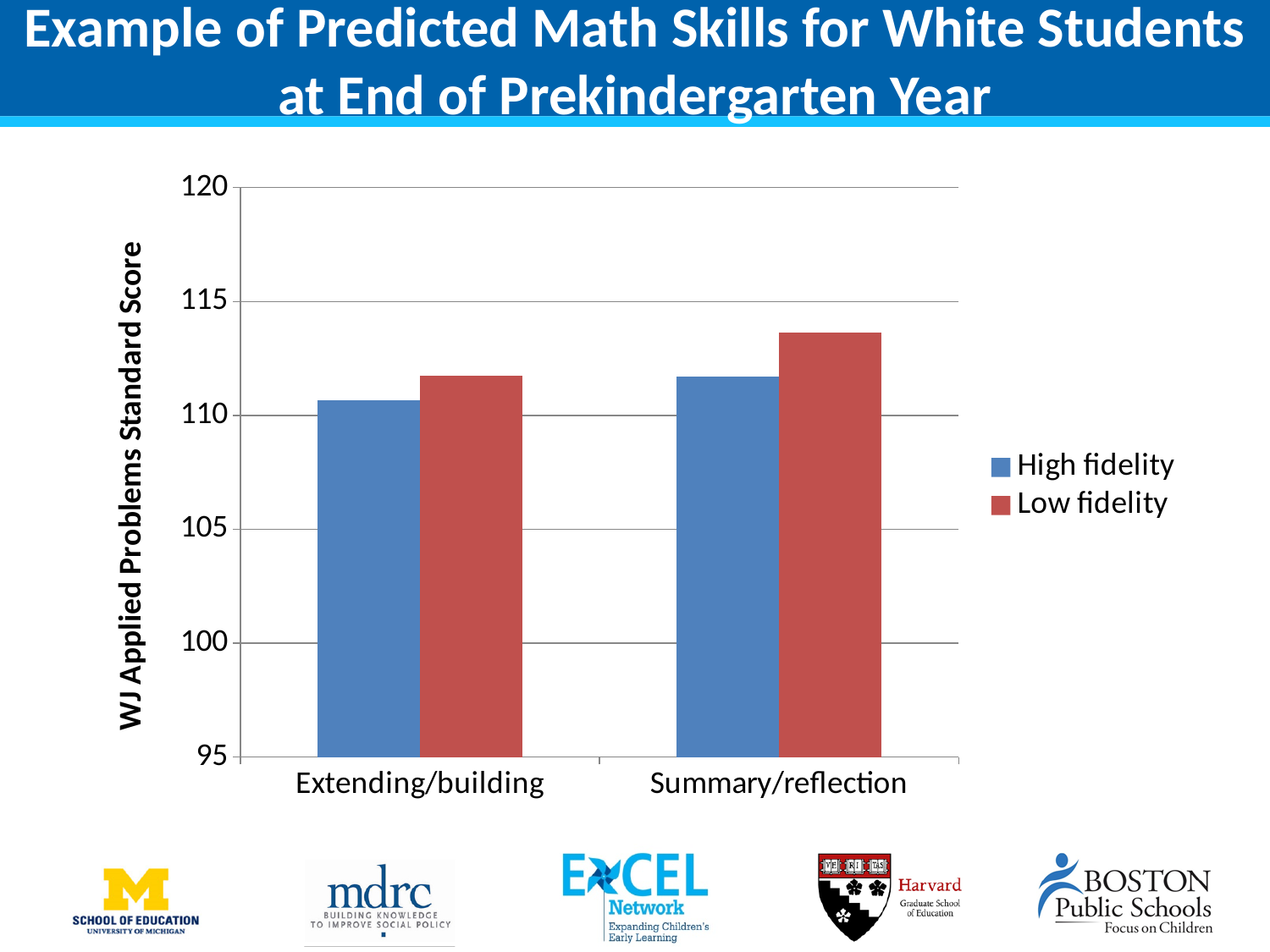
For Extending/building, which is larger: High fidelity or Low fidelity? Low fidelity What kind of chart is shown on the slide? bar chart For Summary/reflection, which is larger: High fidelity or Low fidelity? Low fidelity How many categories are shown on the x axis? 2 Which bar is the tallest in the chart? Low fidelity, Summary/reflection Which bar is the shortest in the chart? High fidelity, Extending/building Is the Low fidelity value for Extending/building greater or less than 110? greater Which series is shown in red? Low fidelity Is the High fidelity value for Extending/building greater or less than 110? greater How many series does the legend list? 2 What is the label of the y axis? WJ Applied Problems Standard Score Is the Low fidelity value for Summary/reflection greater or less than 115? less